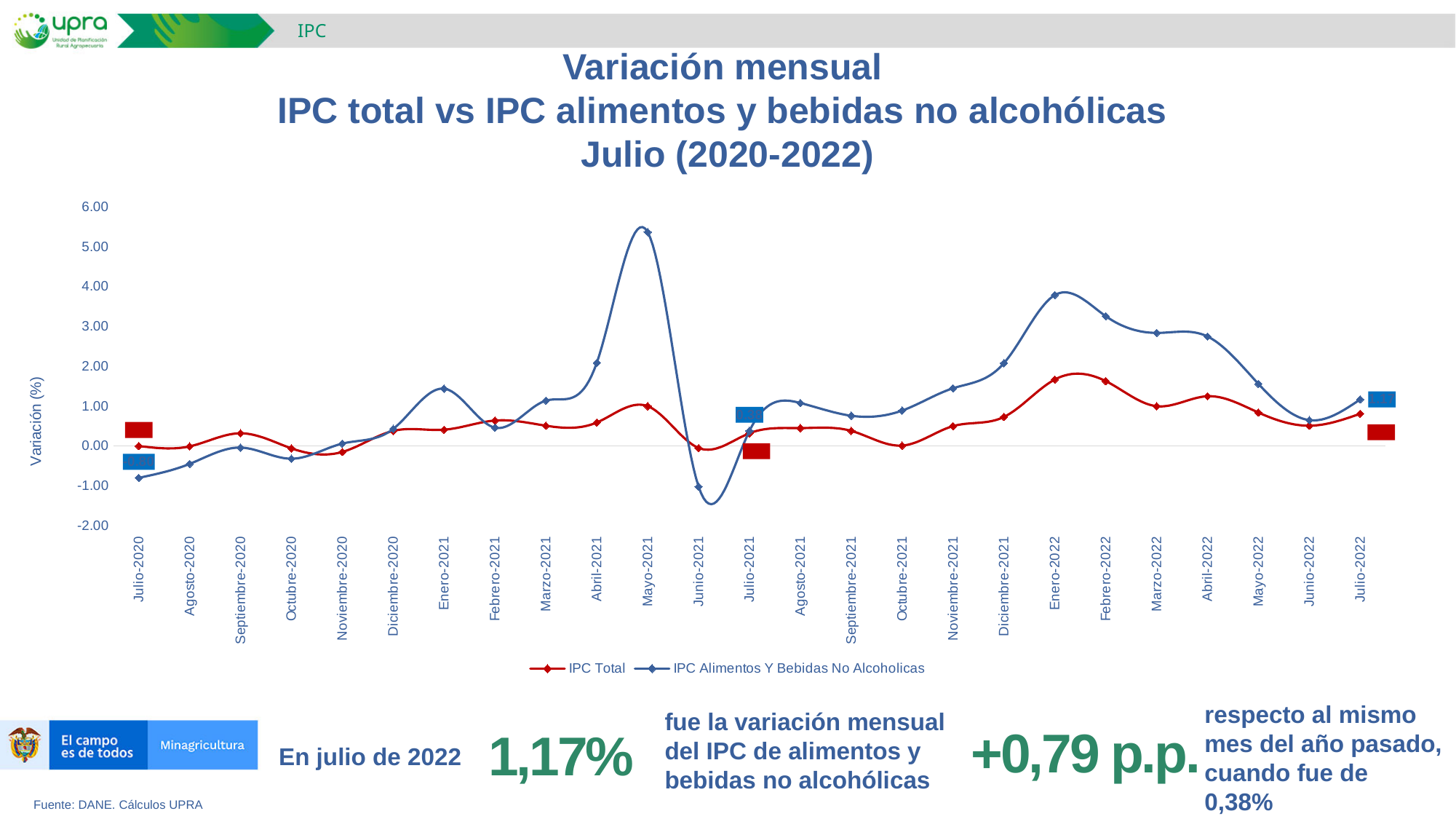
How many months are plotted along the x axis? 25 In which month does the IPC Alimentos Y Bebidas No Alcoholicas series reach its highest value? Mayo-2021 In Mayo-2021, which series has the higher value, IPC Total or IPC Alimentos Y Bebidas No Alcoholicas? IPC Alimentos Y Bebidas No Alcoholicas How many series does the legend list? 2 In which month does the IPC Alimentos Y Bebidas No Alcoholicas series reach its lowest value? Junio-2021 Is the value of IPC Alimentos Y Bebidas No Alcoholicas in Mayo-2021 greater or less than 5.00? greater What kind of chart is shown on the slide? line chart What is the label of the y axis? Variación (%) Does the IPC Alimentos Y Bebidas No Alcoholicas series rise or fall from Enero-2022 to Junio-2022? fall Is the value of IPC Alimentos Y Bebidas No Alcoholicas in Enero-2022 greater or less than 3.00? greater In Julio-2020, which series has the higher value, IPC Total or IPC Alimentos Y Bebidas No Alcoholicas? IPC Total